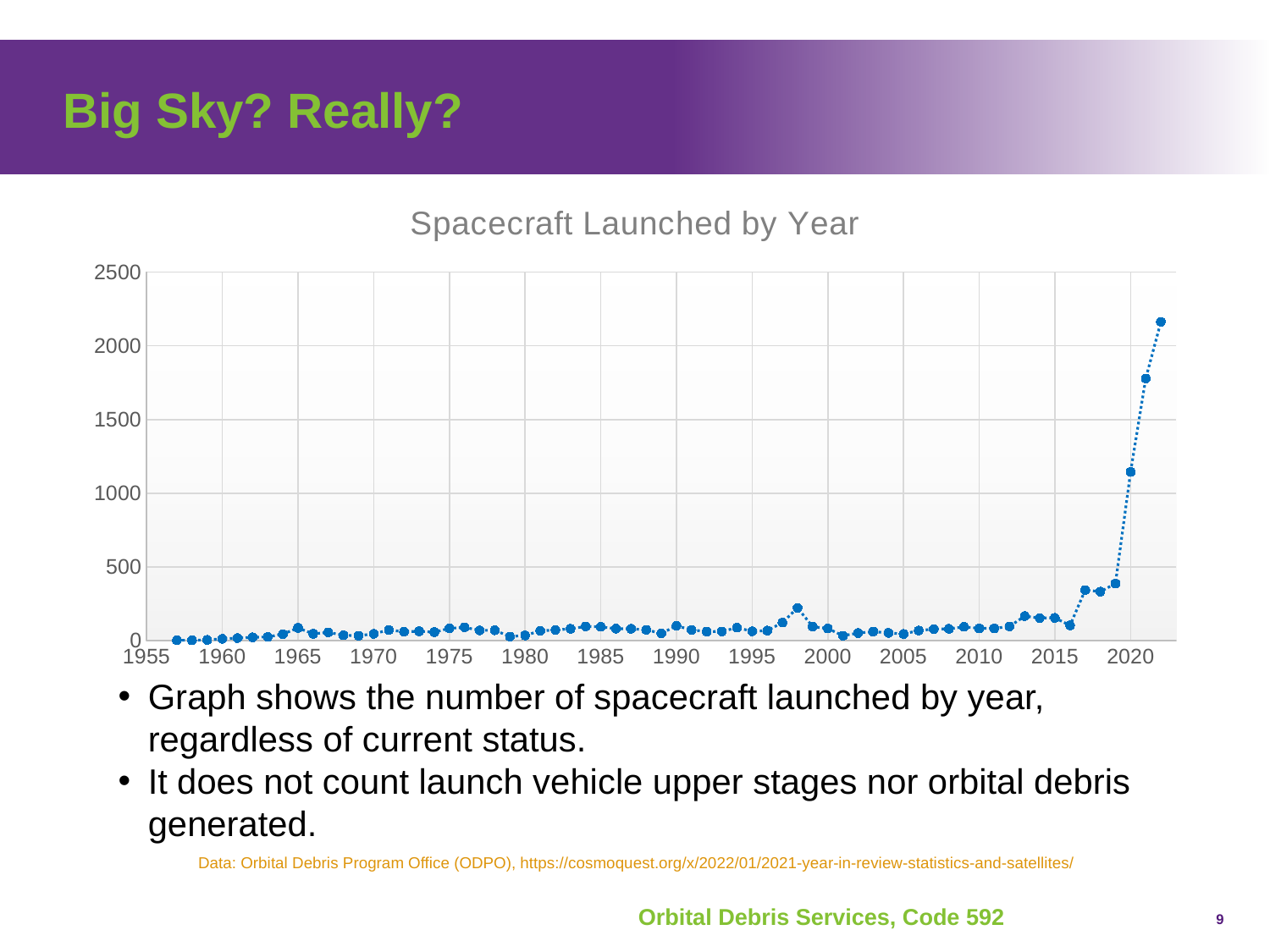
Is the value for the last plotted year (2022) greater or less than 2000? greater Which year has the highest number of spacecraft launched? 2022 Is the value for 2020 greater or less than 1000? greater Which is larger, the value for 1998 or the value for 1990? 1998 What is the highest value shown on the vertical axis? 2500 Do the values rise or fall from 2016 to 2022? rise What kind of chart is shown on the slide? line chart Which is larger, the value for 2022 or the value for 2021? 2022 What is the title of the chart? Spacecraft Launched by Year Is the value for 2021 greater or less than 1500? greater